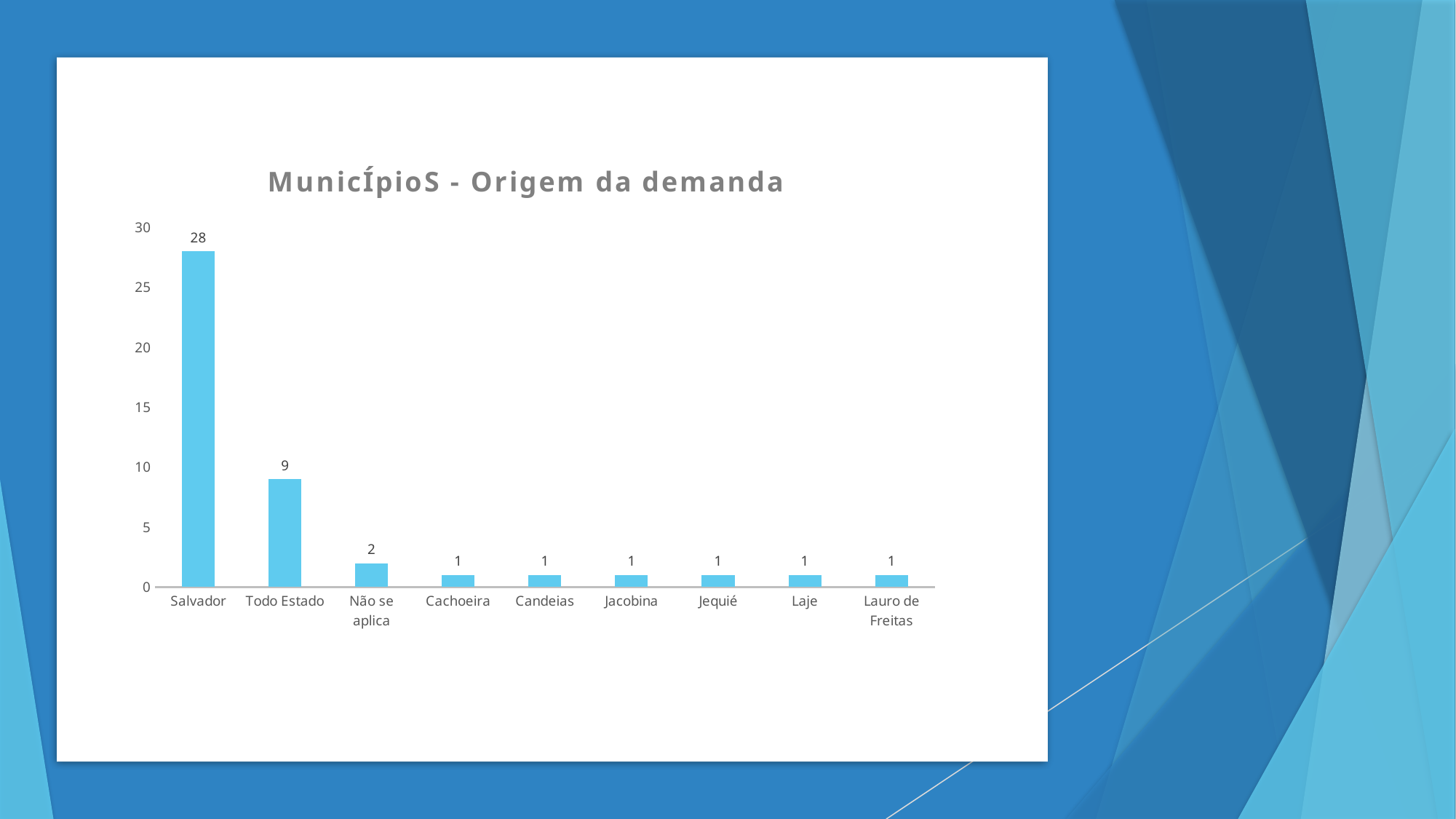
What is the title of the chart? MunicÍpioS - Origem da demanda What kind of chart is shown on the slide? bar chart What is the difference between the values for Salvador and Todo Estado? 19 What is the value for Salvador? 28 What is the difference between the values for Todo Estado and Não se aplica? 7 What is the value for Todo Estado? 9 Is the value for Salvador greater or less than 25? greater Which is larger, the value for Todo Estado or the value for Não se aplica? Todo Estado What is the value for Jacobina? 1 What is the value for Não se aplica? 2 How many categories are shown on the x axis? 9 Which category has the highest value? Salvador